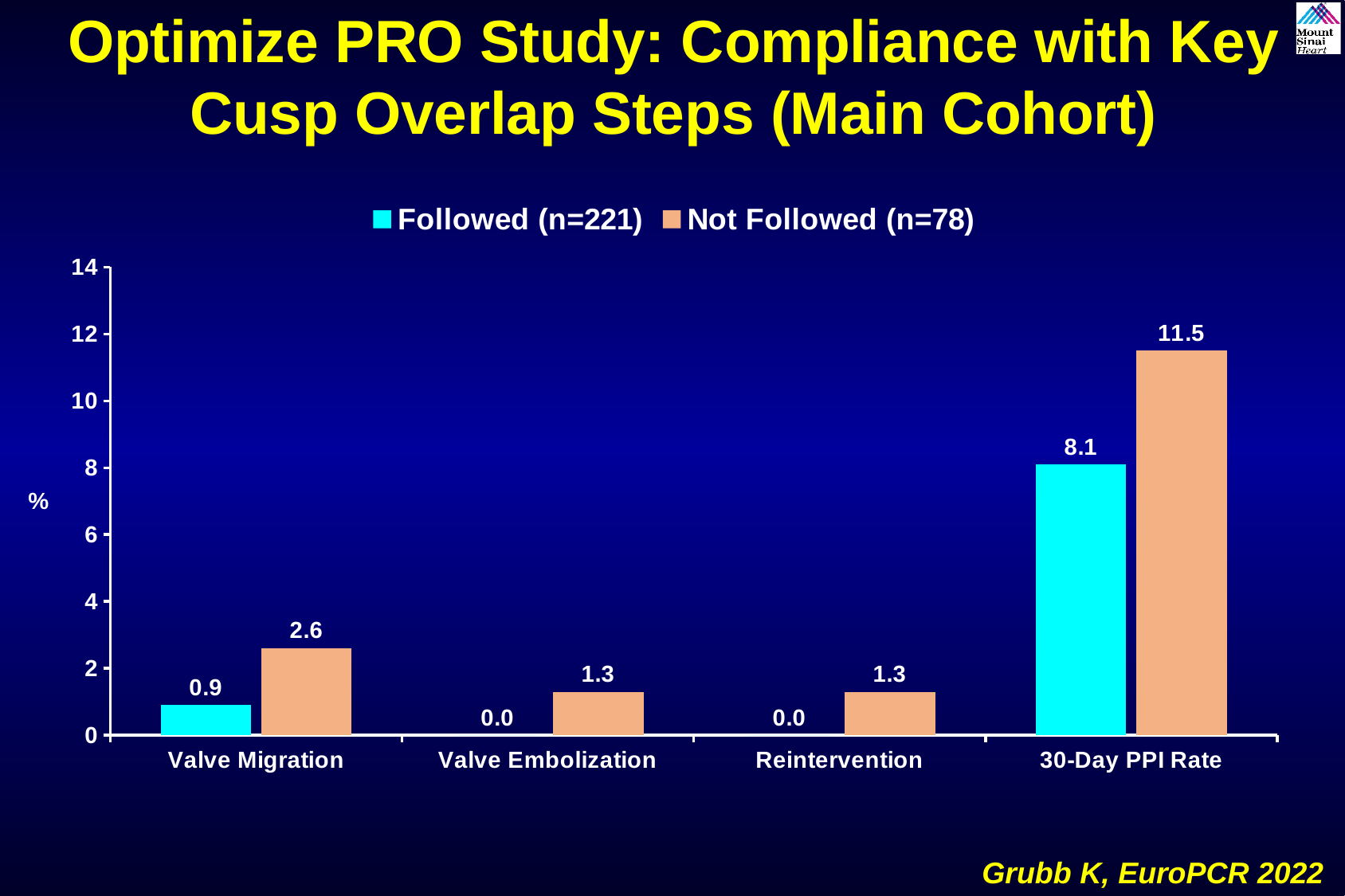
What is the difference between the Not Followed and Followed values for 30-Day PPI Rate? 3.4 Is the Not Followed value for 30-Day PPI Rate greater or less than 10? greater What is the Valve Migration value for the Not Followed (n=78) group? 2.6 What is the Reintervention value for the Followed (n=221) group? 0.0 What is the label on the y axis? % How many series does the legend list? 2 What kind of chart is shown on the slide? Bar chart Which category has the highest value for the Not Followed (n=78) series? 30-Day PPI Rate For Valve Embolization, which group has the larger value, Followed or Not Followed? Not Followed (n=78) What is the 30-Day PPI Rate for the Followed (n=221) group? 8.1 What is the difference between the Not Followed and Followed values for Valve Migration? 1.7 How many categories are shown on the x axis? 4